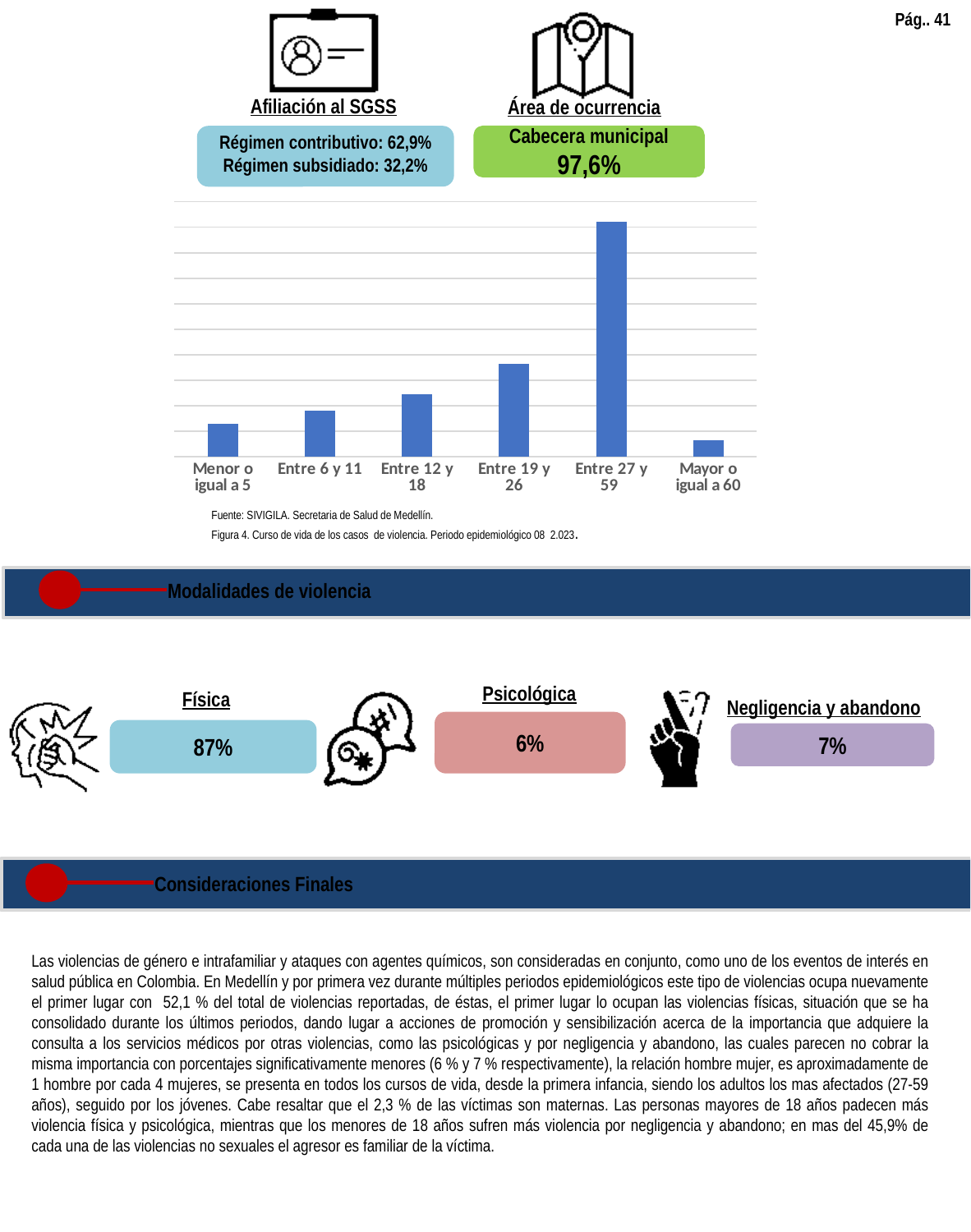
Which has the taller bar: Entre 6 y 11 or Entre 12 y 18? Entre 12 y 18 What is the label of the first category on the x axis of the bar chart? Menor o igual a 5 Do the bar values rise or fall from Menor o igual a 5 through Entre 27 y 59? rise Which has the taller bar: Entre 19 y 26 or Entre 27 y 59? Entre 27 y 59 What source is cited below the bar chart? SIVIGILA. Secretaria de Salud de Medellín. Which has the taller bar: Entre 12 y 18 or Entre 19 y 26? Entre 19 y 26 Which age group has the highest bar in the chart? Entre 27 y 59 What kind of chart is shown in Figura 4 (Curso de vida de los casos de violencia)? bar chart Which age group has the lowest bar in the chart? Mayor o igual a 60 How many age-group categories are shown on the x axis of the bar chart? 6